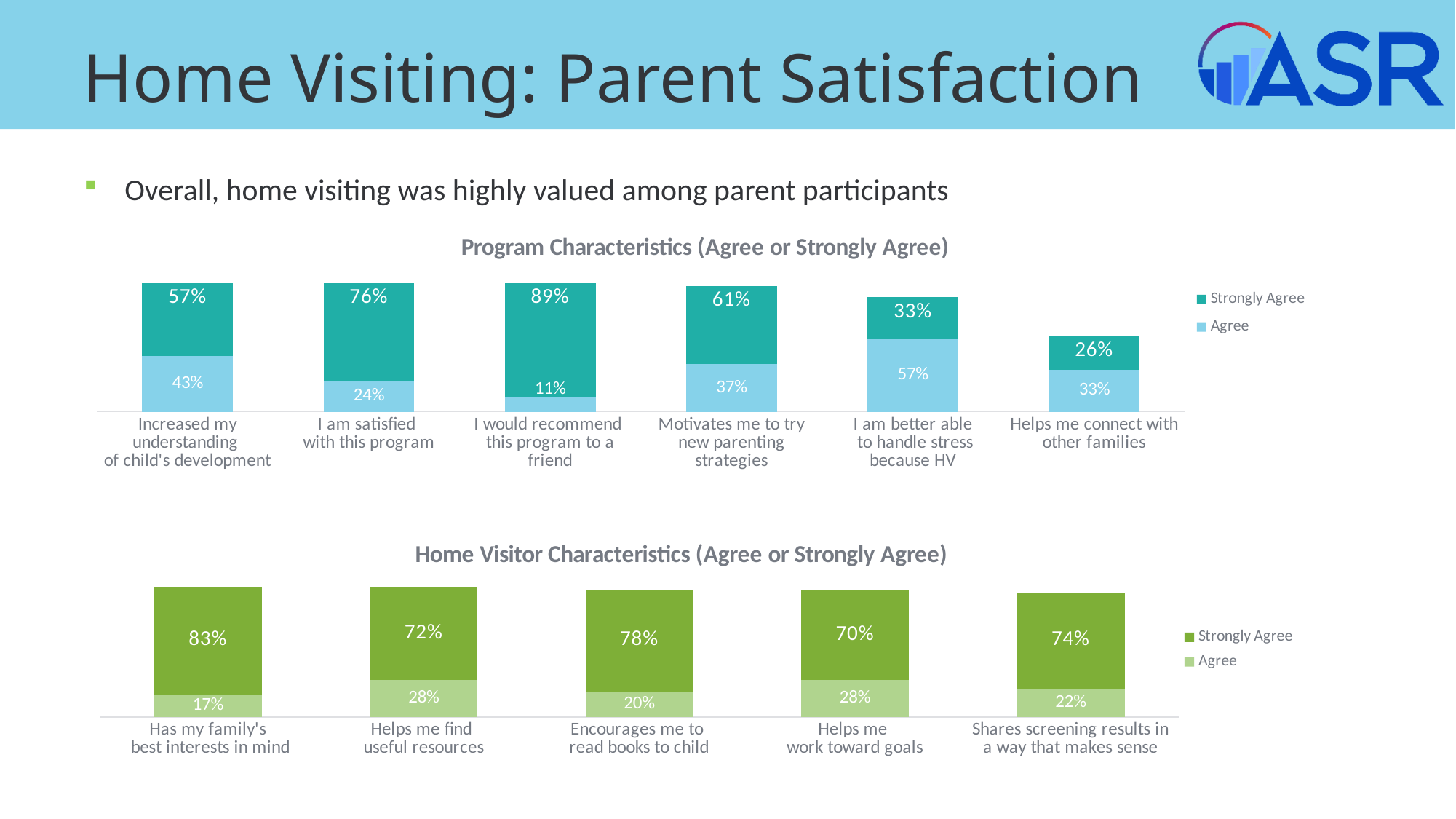
How many categories are shown in the Program Characteristics chart? 6 In the Home Visitor Characteristics chart, what is the Strongly Agree value for "Helps me work toward goals"? 70% What type of chart is the Home Visitor Characteristics chart? Stacked bar chart In the Program Characteristics chart, which category has the lowest Strongly Agree value? Helps me connect with other families In the Home Visitor Characteristics chart, which is larger: the Agree value for "Helps me find useful resources" or for "Shares screening results in a way that makes sense"? Helps me find useful resources In the Home Visitor Characteristics chart, which category has the highest Strongly Agree value? Has my family's best interests in mind In the Program Characteristics chart, what is the Agree value for "I am better able to handle stress because HV"? 57% In the Program Characteristics chart, what is the difference between the Strongly Agree values for "I am satisfied with this program" and "Increased my understanding of child's development"? 19% In the Program Characteristics chart, what is the Strongly Agree value for "I would recommend this program to a friend"? 89% In the Program Characteristics chart, what is the total of the stacked bar for "Helps me connect with other families"? 59% In the Home Visitor Characteristics chart, what is the total of the stacked bar for "Encourages me to read books to child"? 98% How many series does the legend of the Home Visitor Characteristics chart list? 2